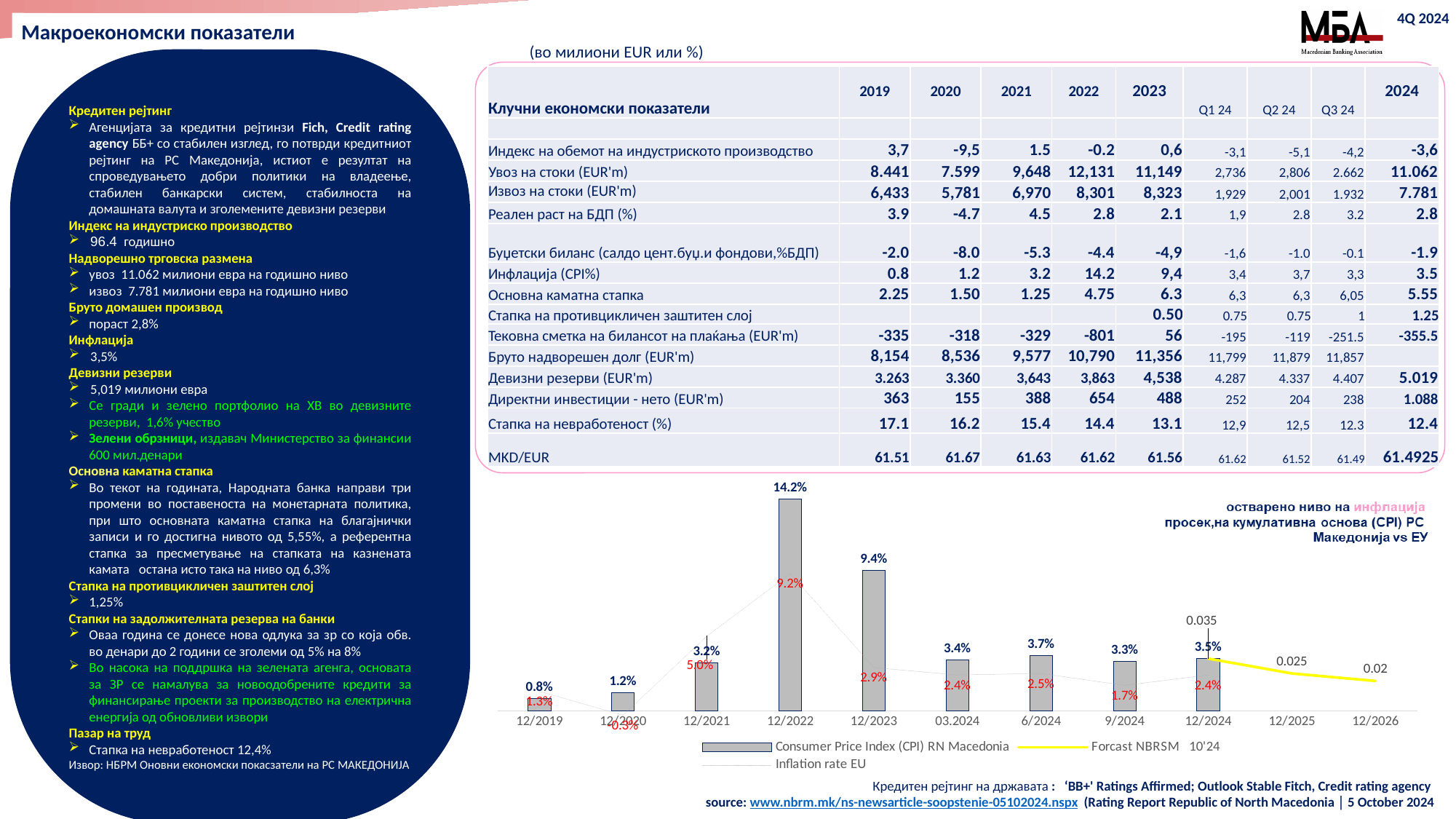
In the inflation chart, what is the difference between the CPI RN Macedonia values for 12/2022 and 12/2023? 4.8% In the inflation chart, what is the Forcast NBRSM 10'24 value for 12/2026? 0.02 In the inflation chart, what is the Inflation rate EU value for 12/2020? -0.3% In the inflation chart, which is larger for 12/2023: CPI RN Macedonia or Inflation rate EU? CPI RN Macedonia In the inflation chart, does the Forcast NBRSM 10'24 line rise or fall from 12/2024 to 12/2026? fall How many series does the legend of the inflation chart list? 3 What type of chart is shown at the bottom of the slide? combination bar and line chart In the inflation chart, which period has the highest CPI RN Macedonia value? 12/2022 In the inflation chart, what is the Inflation rate EU value for 12/2021? 5.0% In the inflation chart, which period has the lowest CPI RN Macedonia value? 12/2019 In the inflation chart, what is the Consumer Price Index (CPI) RN Macedonia value for 12/2022? 14.2% In the inflation chart, how many periods are shown on the x axis? 11